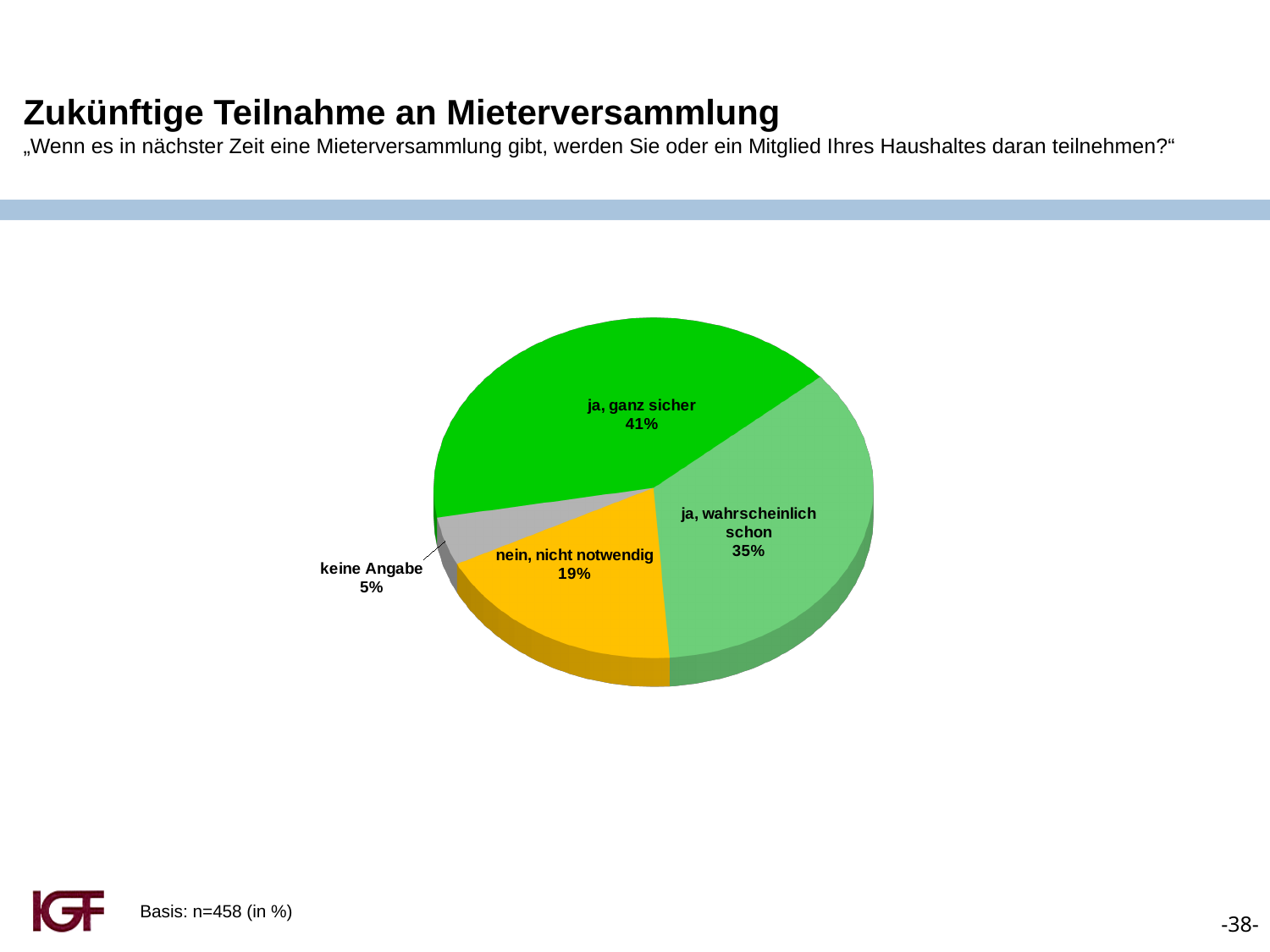
Which answer category has the largest share of the pie? ja, ganz sicher How many slices does the pie chart have? 4 What is the difference in percentage points between "ja, ganz sicher" and "ja, wahrscheinlich schon"? 6 percentage points What share of respondents answered "ja, wahrscheinlich schon"? 35% Which is larger: the share for "nein, nicht notwendig" or the share for "keine Angabe"? nein, nicht notwendig What share of respondents answered "nein, nicht notwendig"? 19% Which answer category has the smallest share of the pie? keine Angabe What is the combined share of the two "ja" answers ("ja, ganz sicher" and "ja, wahrscheinlich schon")? 76% What share of respondents gave "keine Angabe"? 5% What kind of chart is shown on the slide? pie chart What share of respondents answered "ja, ganz sicher"? 41% What is the title of the chart slide? Zukünftige Teilnahme an Mieterversammlung